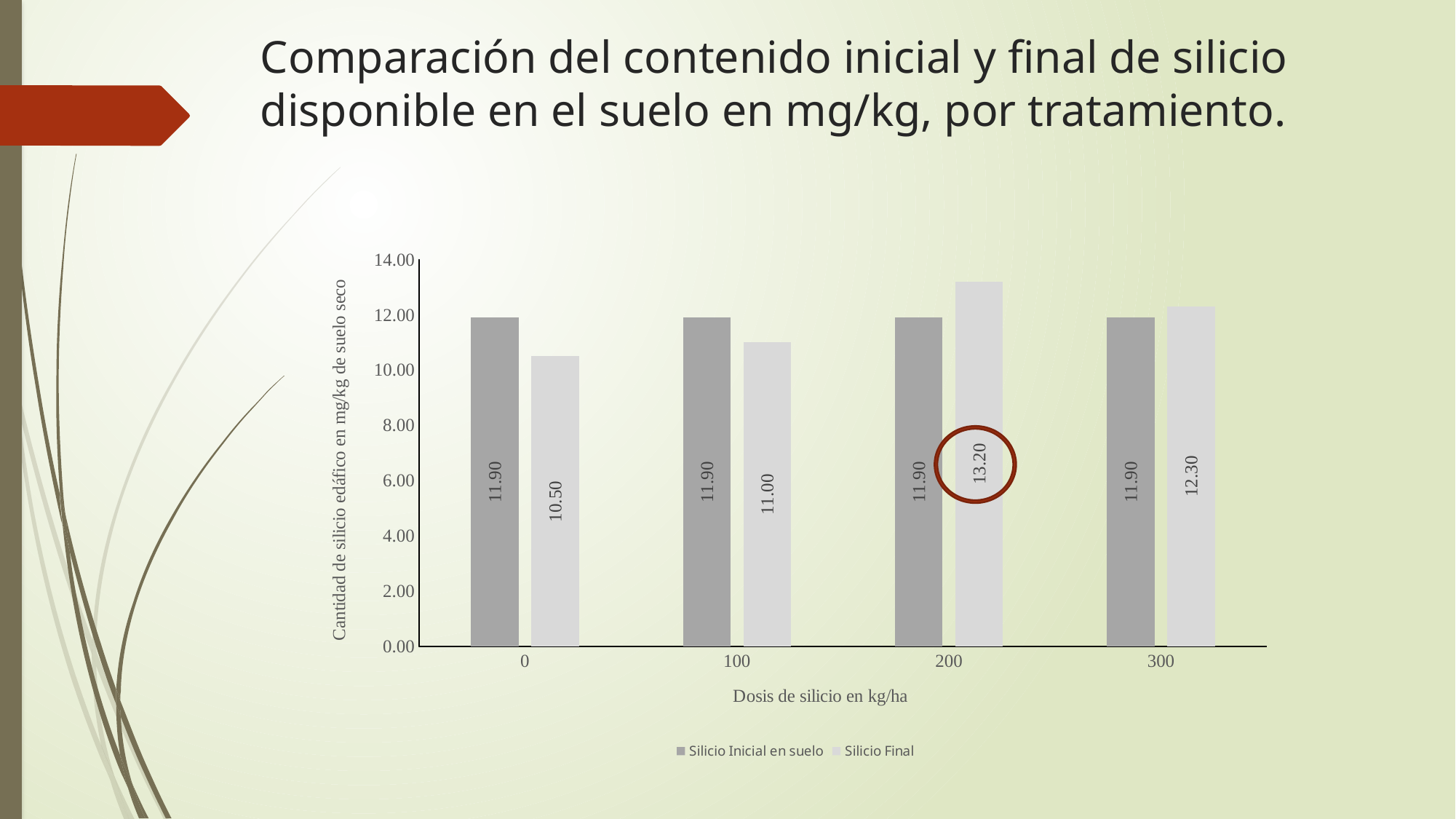
At a dose of 100 kg/ha, which is larger: Silicio Inicial en suelo or Silicio Final? Silicio Inicial en suelo What is the Silicio Final value at a dose of 300 kg/ha? 12.30 How many dose categories are shown on the x axis? 4 Which dose has the lowest Silicio Final value? 0 Which dose has the highest Silicio Final value? 200 What is the Silicio Final value at a dose of 0 kg/ha? 10.50 Do the Silicio Final values rise or fall from a dose of 0 to a dose of 200 kg/ha? Rise How many series does the legend list? 2 What kind of chart is shown on the slide? Bar chart What is the difference between the Silicio Final and Silicio Inicial en suelo values at a dose of 200 kg/ha? 1.30 What is the Silicio Inicial en suelo value at a dose of 100 kg/ha? 11.90 What is the Silicio Final value at a dose of 200 kg/ha? 13.20